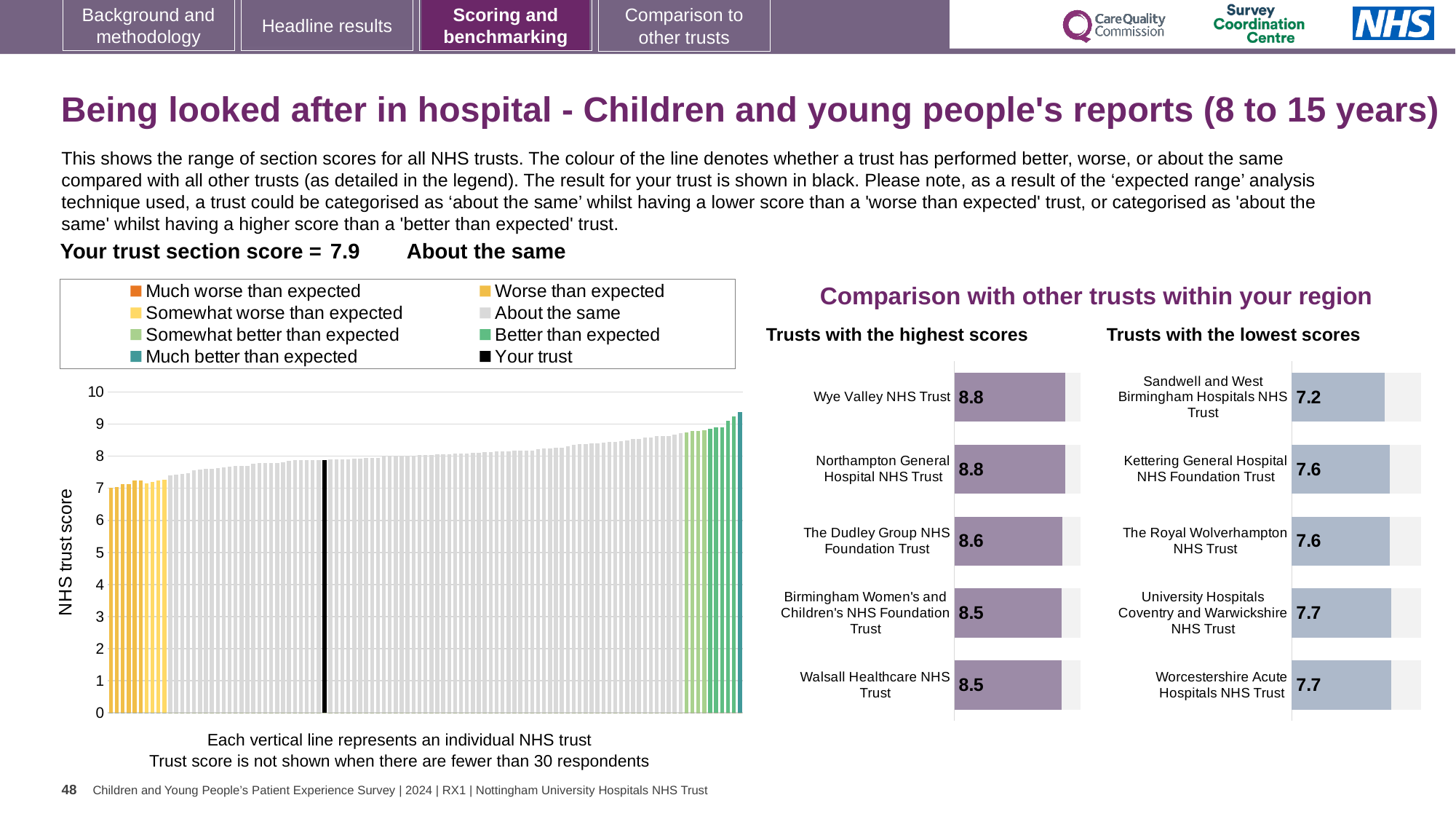
In the 'Trusts with the lowest scores' chart, which trust has the lowest score? Sandwell and West Birmingham Hospitals NHS Trust In the 'Trusts with the lowest scores' chart, what is the score for Kettering General Hospital NHS Foundation Trust? 7.6 How many trusts are shown in the 'Trusts with the lowest scores' chart? 5 Which is larger: the score for The Dudley Group NHS Foundation Trust in the 'Trusts with the highest scores' chart or the score for The Royal Wolverhampton NHS Trust in the 'Trusts with the lowest scores' chart? The Dudley Group NHS Foundation Trust In the 'Trusts with the highest scores' chart, what is the score for The Dudley Group NHS Foundation Trust? 8.6 In the 'Trusts with the highest scores' chart, what is the score for Wye Valley NHS Trust? 8.8 How many entries does the legend of the large chart on the left list? 8 In the large chart on the left showing all NHS trusts, is the value for the leftmost trust greater or less than 8? less In the 'Trusts with the highest scores' chart, what is the difference between the scores for Wye Valley NHS Trust and Walsall Healthcare NHS Trust? 0.3 In the large chart on the left showing all NHS trusts, do the values rise or fall from left to right? rise What is the difference between the score for Wye Valley NHS Trust in the 'Trusts with the highest scores' chart and the score for Sandwell and West Birmingham Hospitals NHS Trust in the 'Trusts with the lowest scores' chart? 1.6 In the large chart on the left showing all NHS trusts, what is the section score for your trust (the black line)? 7.9